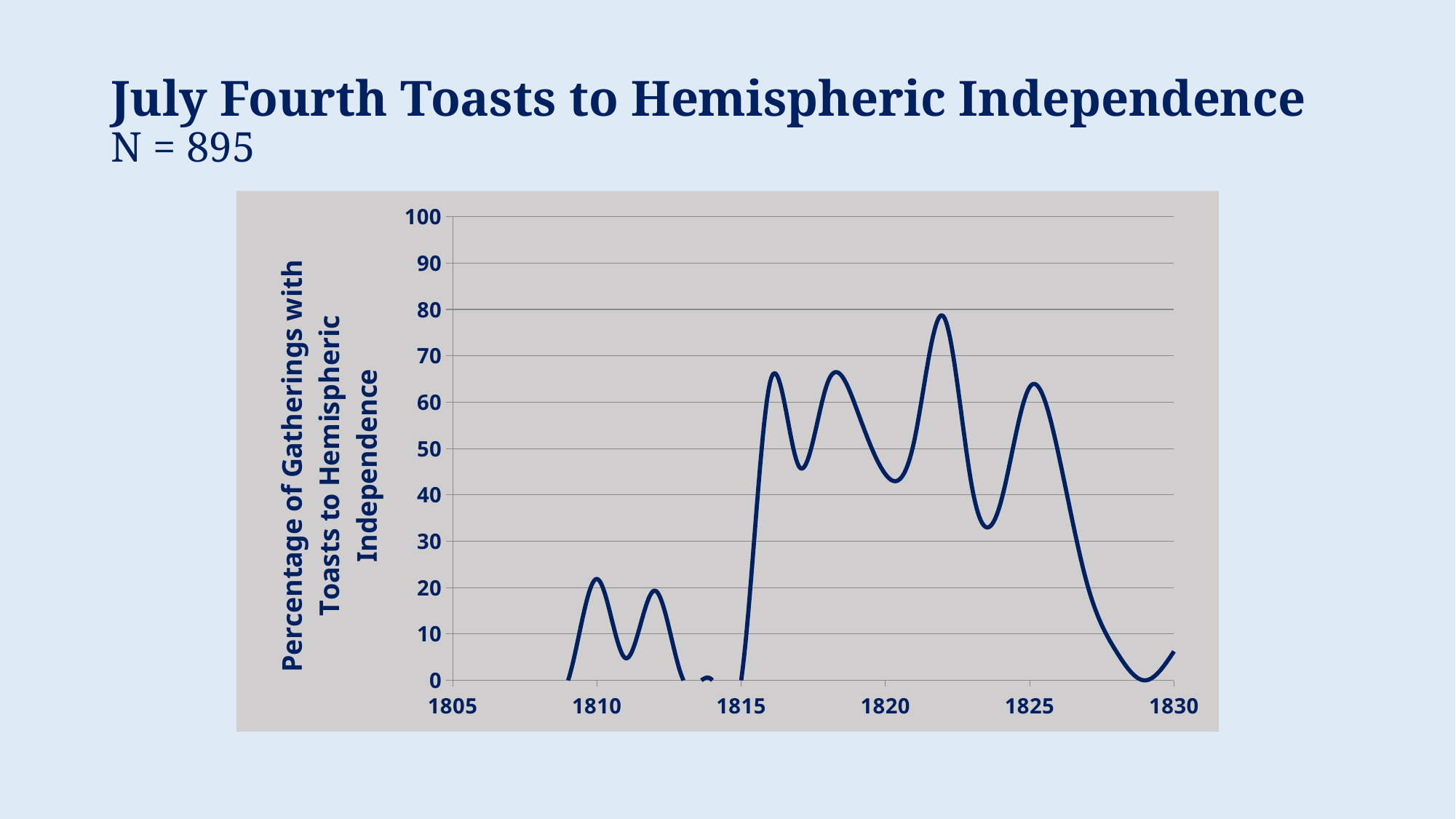
Is the value for 1820 greater or less than 50? less What kind of chart is shown on the slide? line chart What is the title of the slide's chart? July Fourth Toasts to Hemispheric Independence Is the value for 1810 greater or less than 30? less Which year has the larger value, 1810 or 1816? 1816 Is the value for 1825 greater or less than 50? greater What is the label on the vertical axis of the chart? Percentage of Gatherings with Toasts to Hemispheric Independence Which year has the larger value, 1822 or 1825? 1822 In which year does the line reach its highest value? 1822 Does the line rise or fall between 1825 and 1829? fall